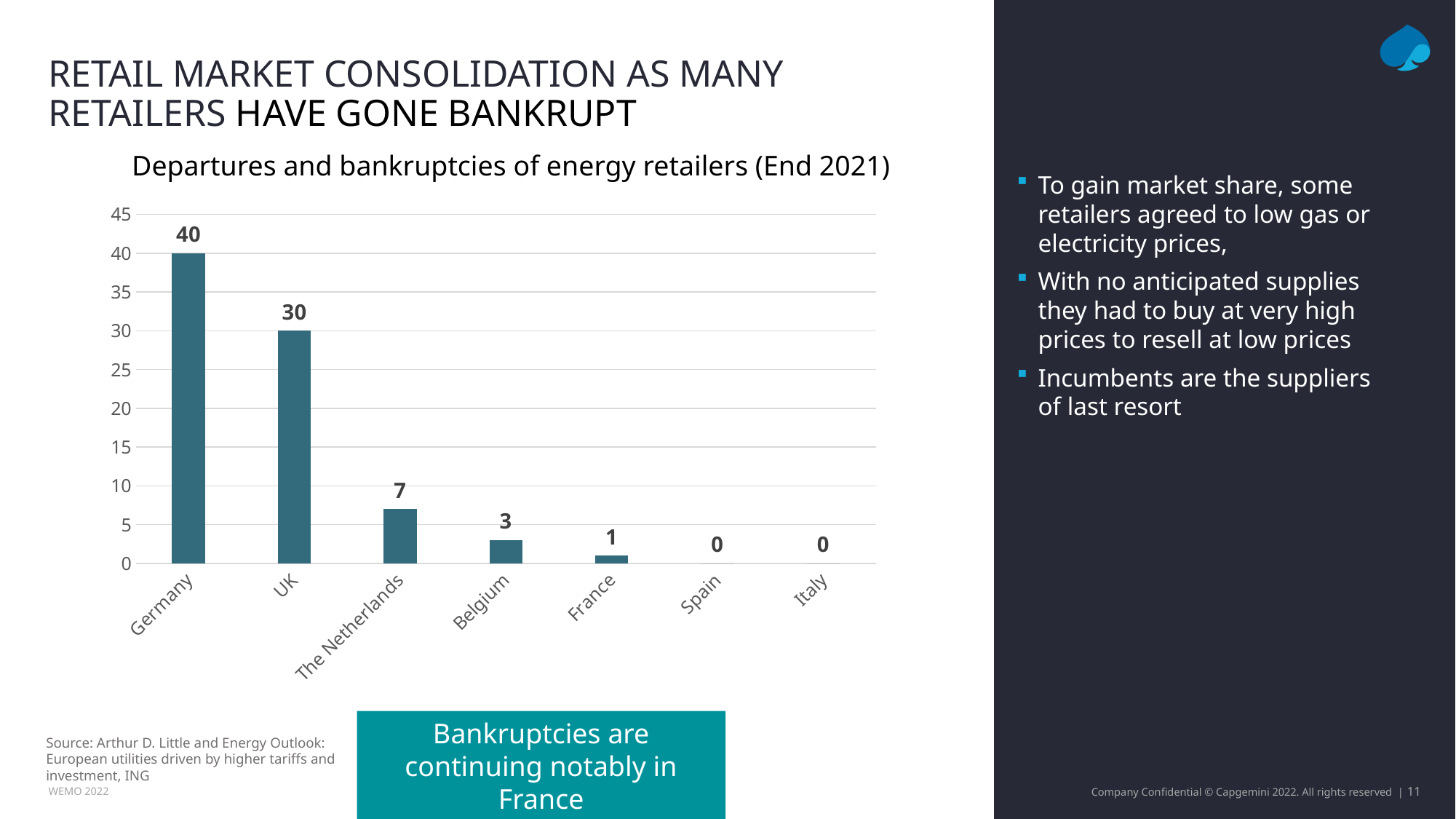
What is the value for Germany? 40 Which is larger, the value for the UK or the value for Belgium? UK Do the values rise or fall from left to right along the x axis? Fall What is the value for France? 1 What is the difference between the values for The Netherlands and Belgium? 4 What kind of chart is shown on the slide? Bar chart How many countries are shown on the x axis? 7 What is the value for The Netherlands? 7 What is the difference between the values for Germany and the UK? 10 What is the title of the chart? Departures and bankruptcies of energy retailers (End 2021) Which country has the highest value? Germany Is the value for the UK greater or less than 25? greater